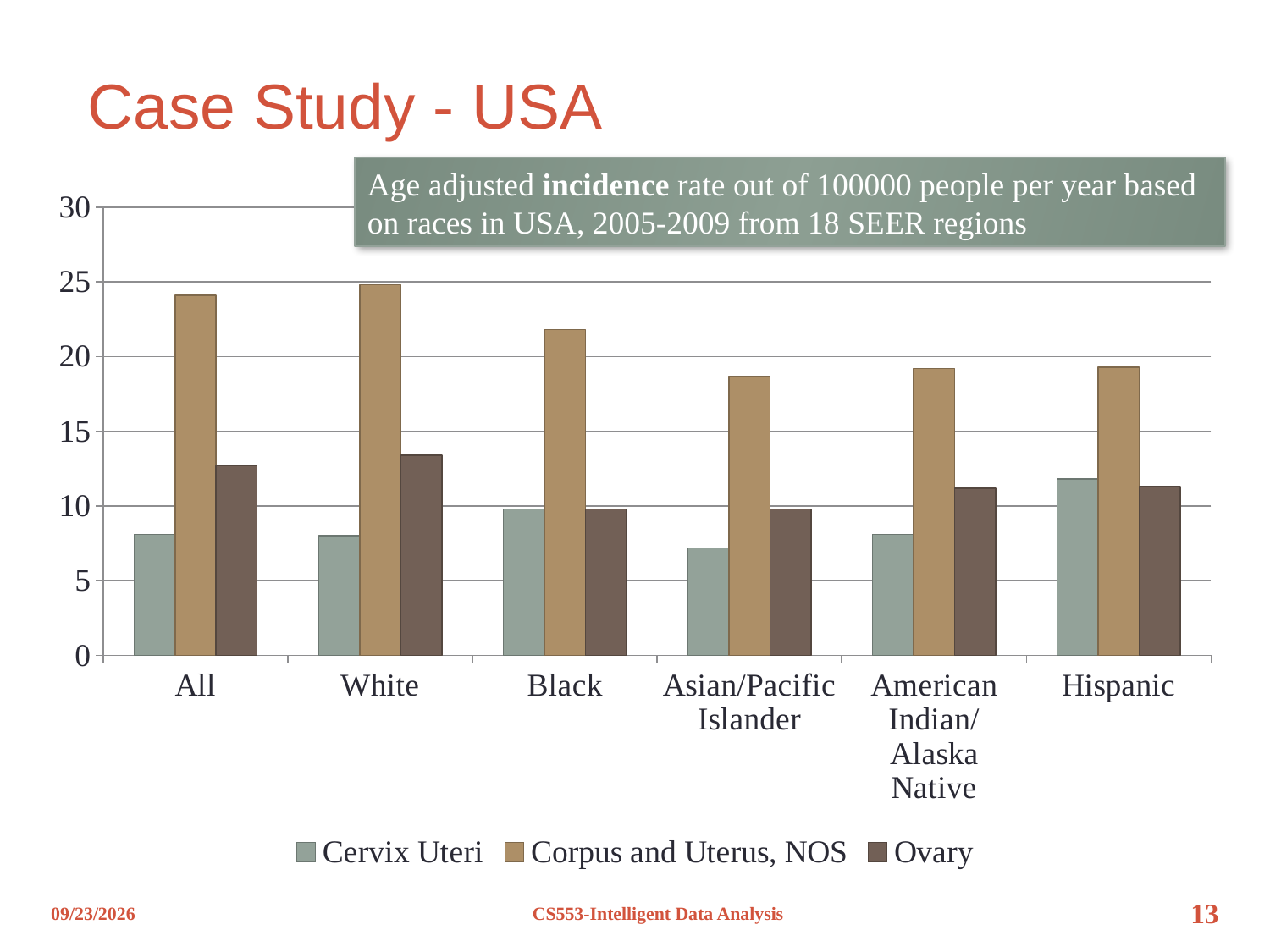
Is the Cervix Uteri value for Asian/Pacific Islander greater or less than 10? less Which is larger: the Cervix Uteri value for Hispanic or the Cervix Uteri value for Black? Hispanic How many race categories are shown on the x axis? 6 Which race category has the highest Cervix Uteri incidence rate? Hispanic What kind of chart is shown on the slide? bar chart How many series does the legend list? 3 For the All category, which is larger: the Cervix Uteri value or the Corpus and Uterus, NOS value? Corpus and Uterus, NOS For the White category, which is larger: the Ovary value or the Cervix Uteri value? Ovary Is the Ovary value for All greater or less than 10? greater Is the Corpus and Uterus, NOS value for White greater or less than 20? greater What are the three series named in the legend? Cervix Uteri; Corpus and Uterus, NOS; Ovary